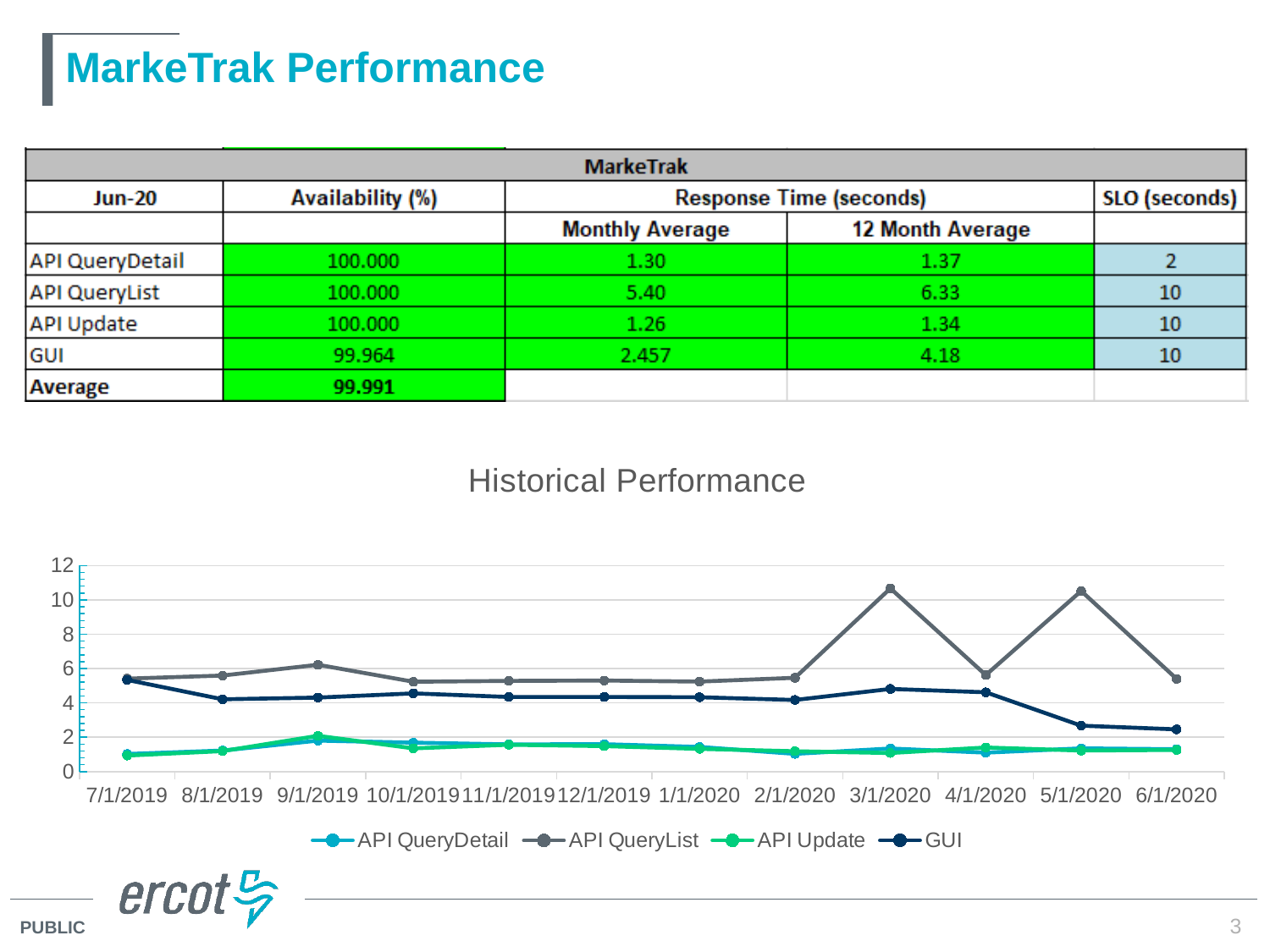
What kind of chart is shown under the heading Historical Performance? line chart In the Historical Performance chart, which series has the highest value at 3/1/2020? API QueryList How many dates are plotted along the x axis of the Historical Performance chart? 12 In the Historical Performance chart, is the value for GUI at 6/1/2020 greater or less than 4? less In the Historical Performance chart, does the GUI series rise or fall from 4/1/2020 to 6/1/2020? fall In the Historical Performance chart, is the value for API QueryList at 9/1/2019 greater or less than 4? greater How many series does the legend of the Historical Performance chart list? 4 In the Historical Performance chart, which is larger at 8/1/2019: API QueryList or GUI? API QueryList In the Historical Performance chart, which is larger: the GUI value at 7/1/2019 or the GUI value at 6/1/2020? 7/1/2019 In the Historical Performance chart, is the value for API Update at 7/1/2019 greater or less than 2? less What is the title of the line chart on the slide? Historical Performance